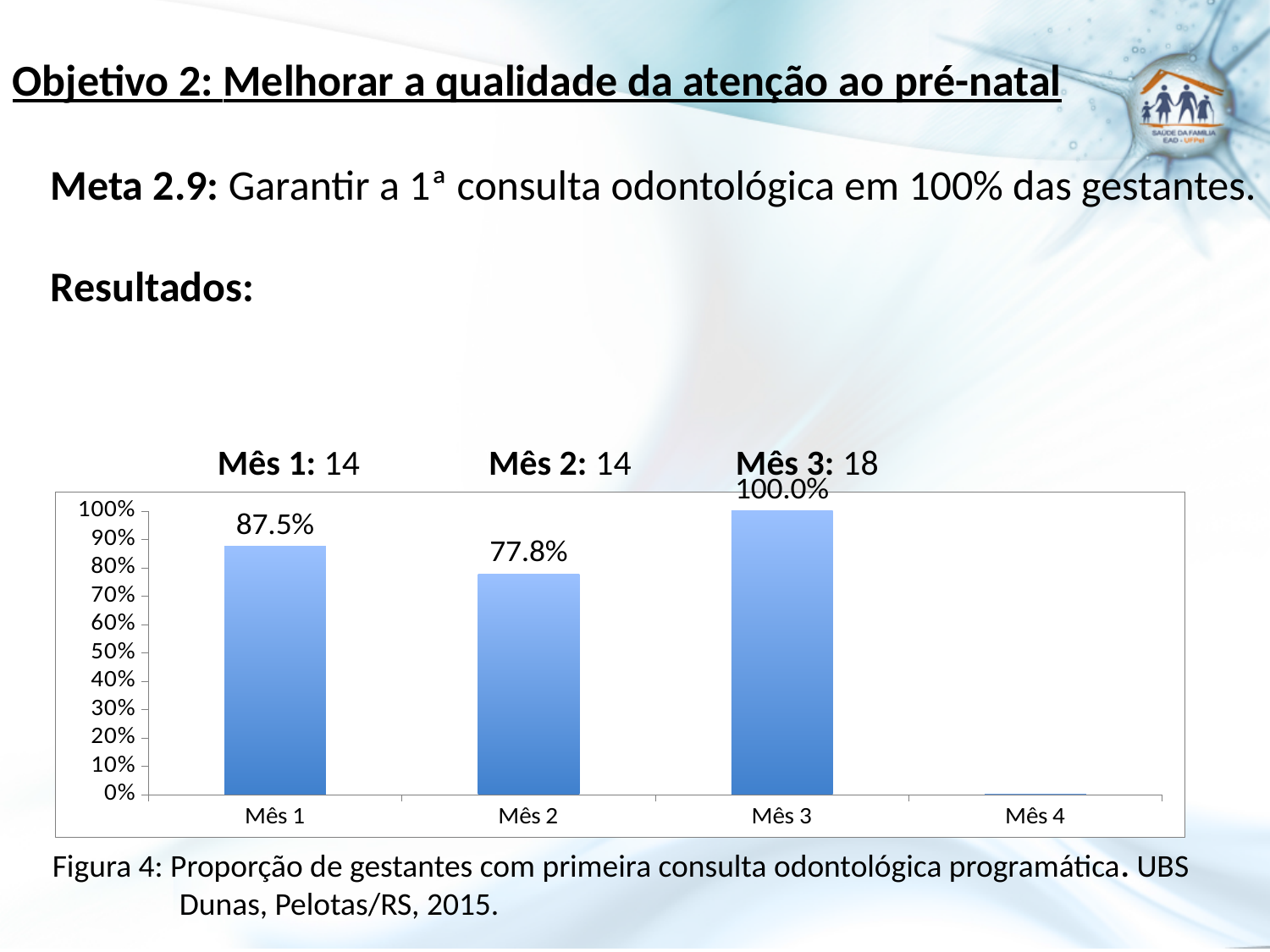
How many months are shown on the x axis? 4 Which month has the highest value? Mês 3 Is the value for Mês 2 greater or less than 80%? less Which month has the lowest value? Mês 4 What is the value for Mês 2? 77.8% Does the value rise or fall from Mês 2 to Mês 3? rise What kind of chart is shown on the slide? bar chart What is the difference between the values for Mês 3 and Mês 1? 12.5% Which is larger, the value for Mês 1 or the value for Mês 2? Mês 1 What is the value for Mês 1? 87.5% What is the difference between the values for Mês 1 and Mês 2? 9.7% What is the value for Mês 3? 100.0%